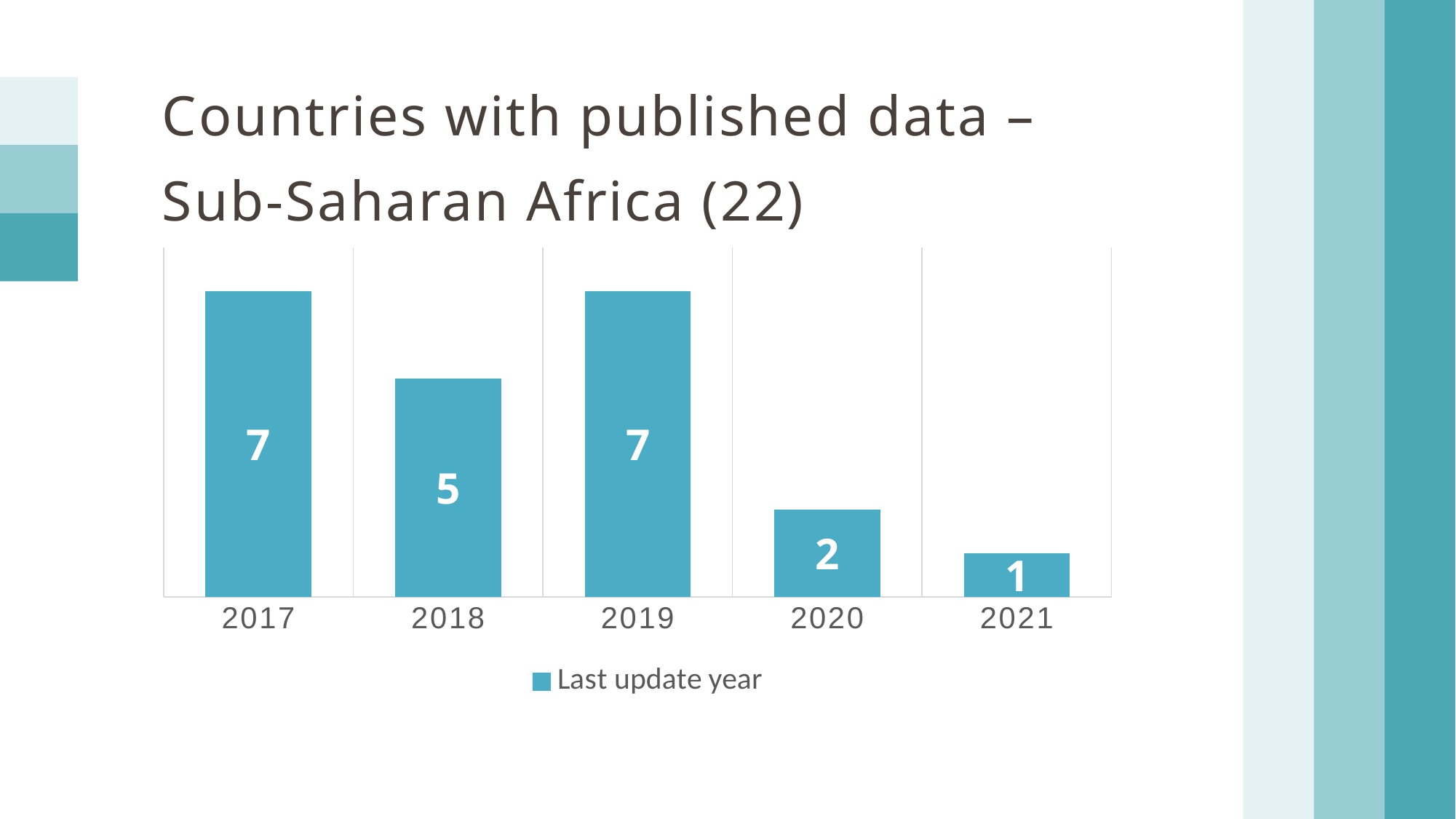
How many years are shown on the x axis? 5 What is the legend entry for the series? Last update year What is the value for 2020? 2 Which is larger, the value for 2018 or the value for 2020? 2018 What is the difference between the values for 2017 and 2018? 2 What is the value for 2017? 7 What kind of chart is shown on the slide? Bar chart Which year has the lowest value? 2021 What is the value for 2018? 5 What is the value for 2021? 1 How many series does the legend list? 1 What is the difference between the values for 2019 and 2020? 5